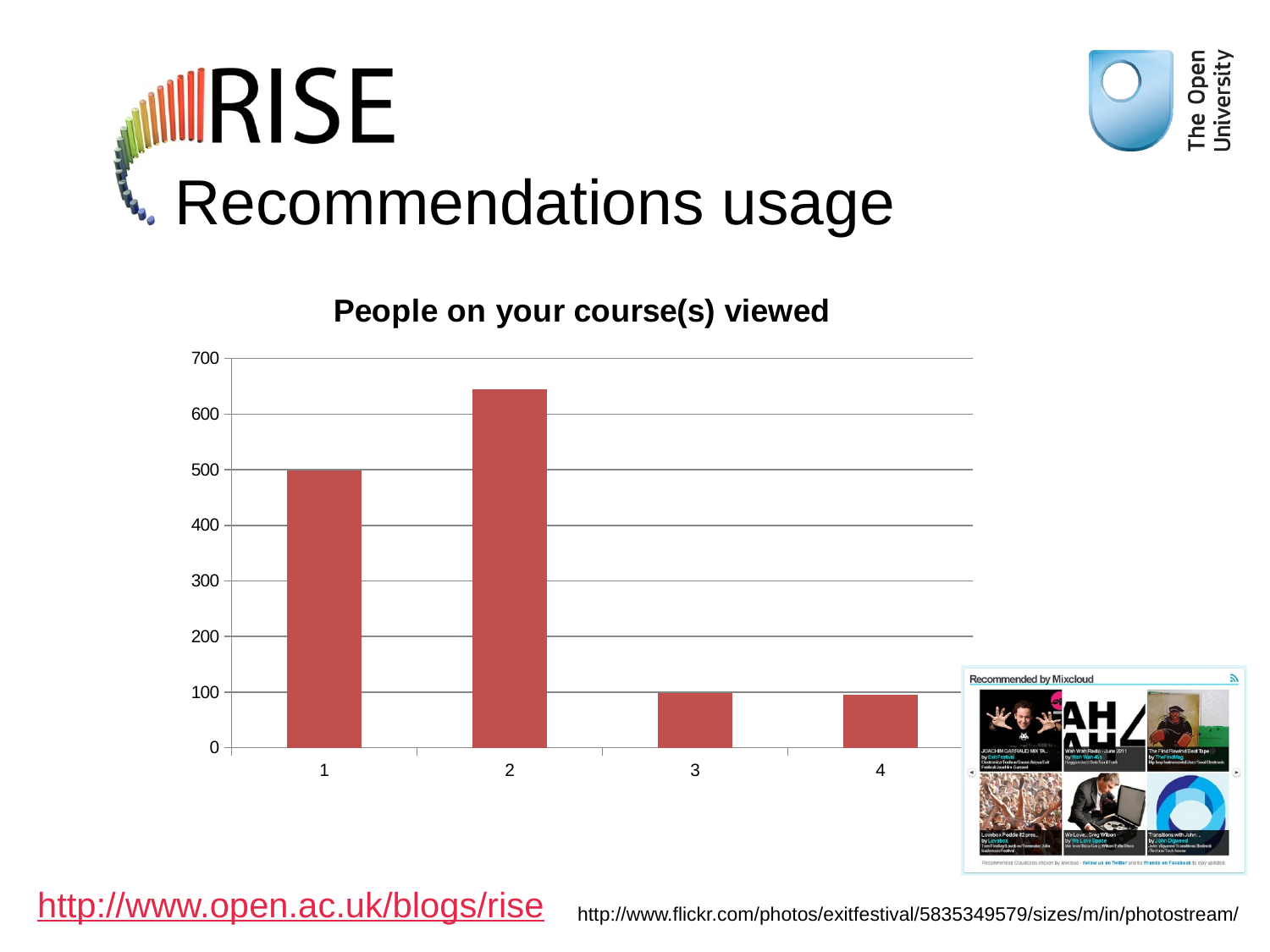
Is the value for category 3 greater or less than 200? less Is the value for category 1 greater or less than 400? greater Which has the larger value, category 1 or category 3? 1 Which has the larger value, category 1 or category 2? 2 How many categories are shown on the x axis of the chart? 4 What kind of chart is shown on the slide? bar chart Which category has the highest value in the chart? 2 Is the value for category 2 greater or less than 700? less What colour are the bars in the chart? red What is the title of the chart? People on your course(s) viewed